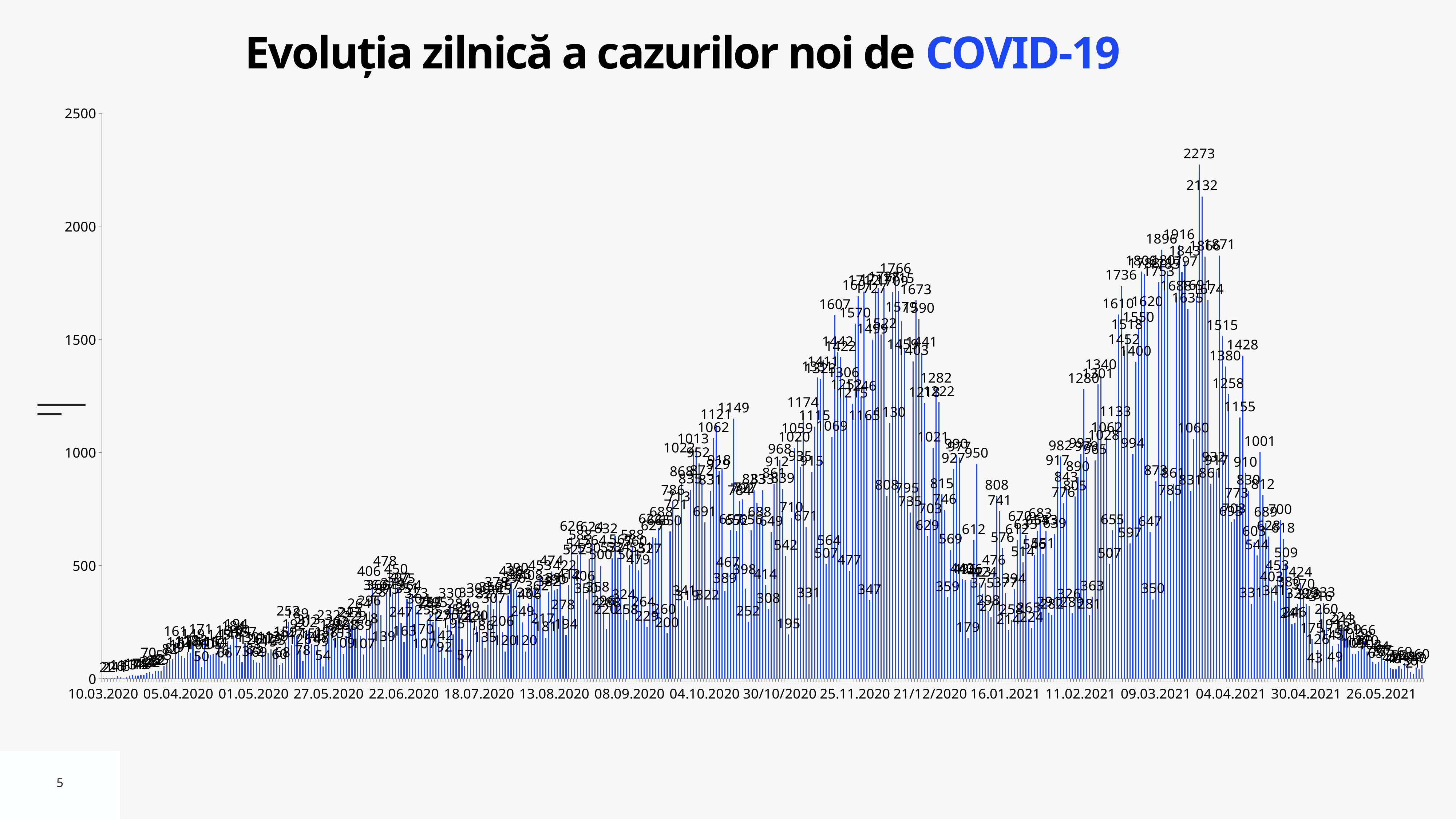
Is the peak value of the wave around 25.11.2020 greater or less than 1500? greater Which is larger: the peak of the wave around 04.04.2021 (2273) or the peak of the wave around 25.11.2020 (1766)? 2273 What is the second-highest value labelled on the chart, next to the 2273 peak? 2132 Are the values at the start of the chart, around 10.03.2020, greater or less than 500? less What is the highest tick value shown on the y axis? 2500 Is the highest value on the chart greater or less than 2000? greater What is the highest daily value labelled on the chart? 2273 What kind of chart is shown on the slide? bar chart What is the title of the chart? Evoluția zilnică a cazurilor noi de COVID-19 What is the difference between the two highest labelled values, 2273 and 2132? 141 Do the values rise or fall along the x axis between 04.04.2021 and 26.05.2021? fall What is the first date label on the x axis? 10.03.2020